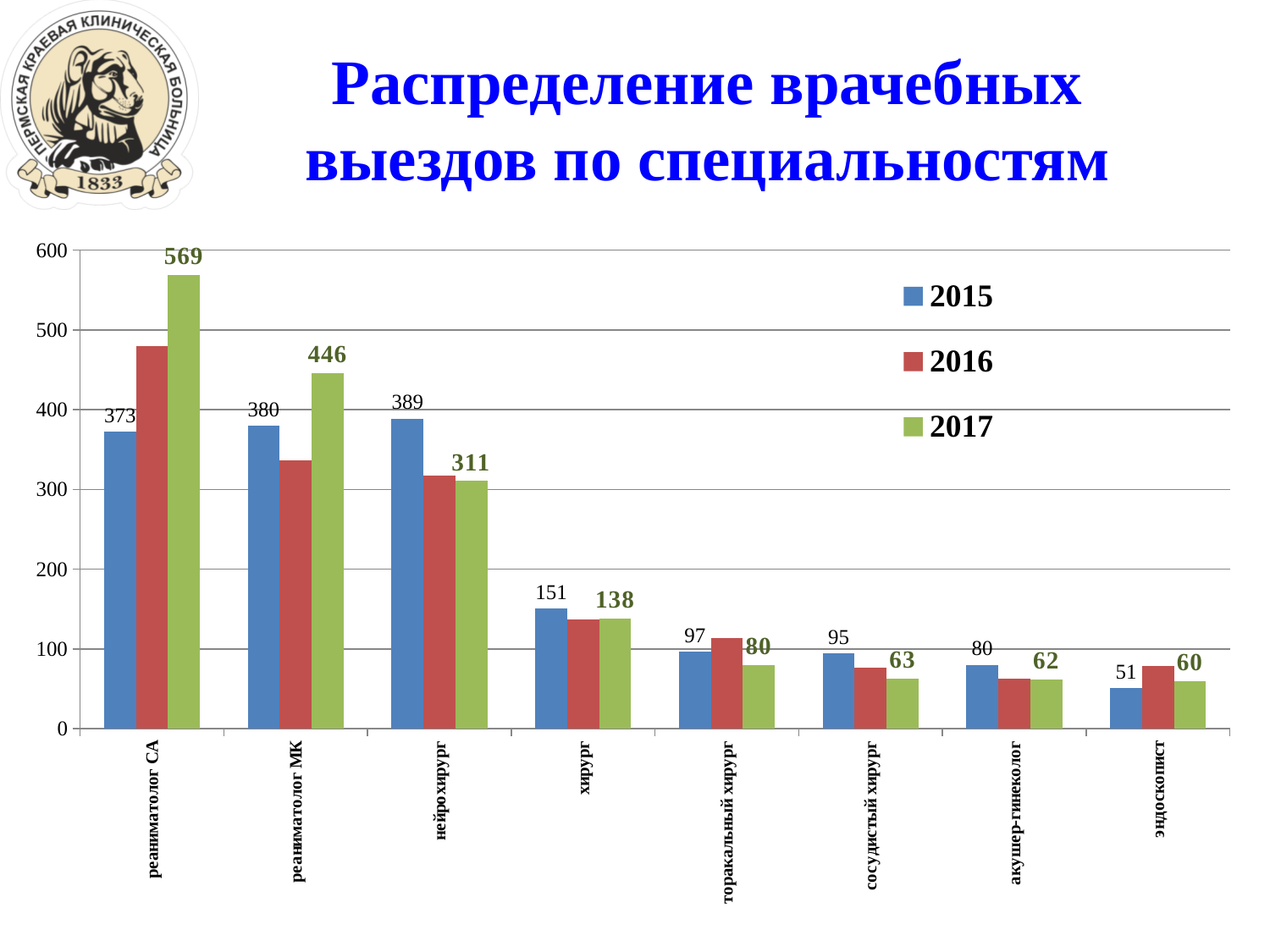
Is the 2016 value for реаниматолог СА greater or less than 400? greater Which is larger for нейрохирург: the 2015 value or the 2017 value? 2015 What kind of chart is shown on the slide? bar chart What is the 2017 value for хирург? 138 How many specialties are shown on the x axis? 8 What is the difference between the 2017 and 2015 values for реаниматолог СА? 196 What is the 2015 value for эндоскопист? 51 What is the 2015 value for нейрохирург? 389 Which specialty has the lowest 2015 value? эндоскопист What is the 2017 value for реаниматолог СА? 569 Which specialty has the highest 2017 value? реаниматолог СА How many series does the legend list? 3